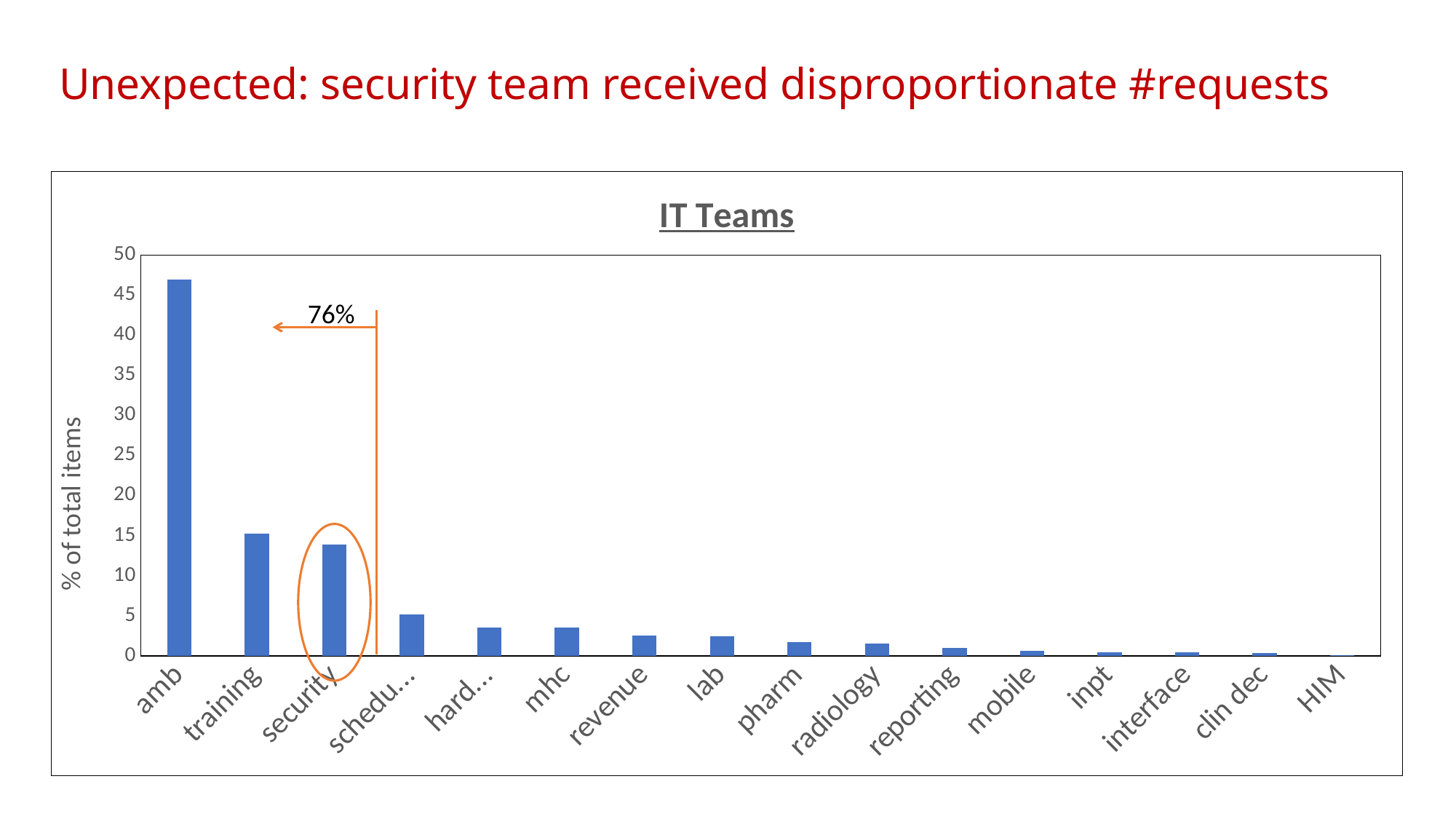
Which has a higher % of total items, mhc or revenue? mhc Is the value for amb greater or less than 40? greater How many IT teams are shown on the x axis of the chart? 16 Which IT team has the highest % of total items? amb What kind of chart is shown on the slide? bar chart What is the title of the chart? IT Teams Is the value for security greater or less than 20? less Is the value for mhc greater or less than 10? less Which IT team has the lowest % of total items? HIM Which has a higher % of total items, training or security? training Do the bar values rise or fall moving from left to right along the x axis? fall What is the label on the vertical axis of the chart? % of total items